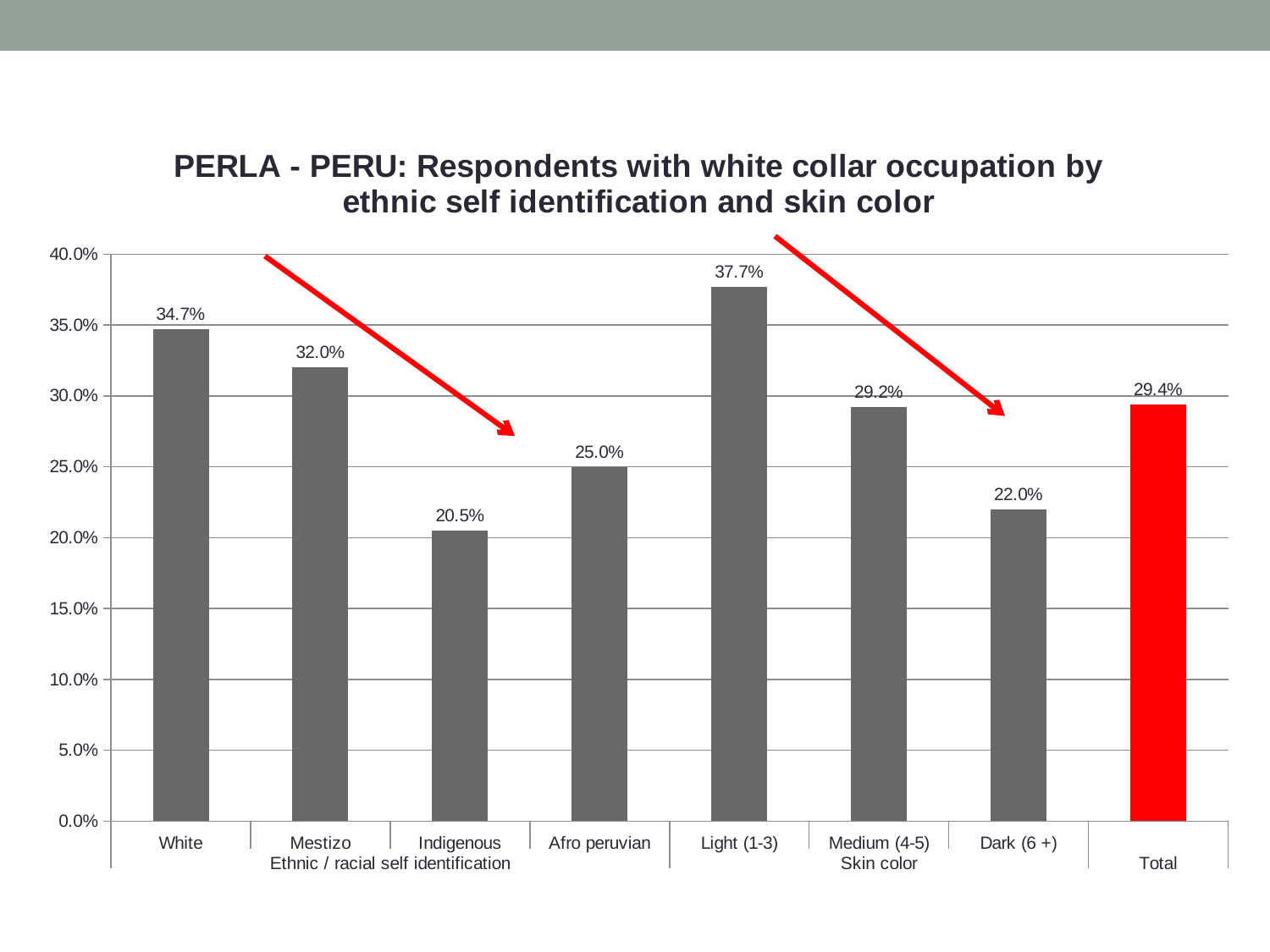
What is the difference between the values for Light (1-3) and Dark (6 +)? 15.7% What colour is the Total bar? Red Which is larger, the value for Afro peruvian or the value for Medium (4-5)? Medium (4-5) What is the value for Indigenous? 20.5% What is the value for White? 34.7% How many bars are shown in the chart? 8 What kind of chart is this? Bar chart Which category has the highest value? Light (1-3) What is the difference between the values for White and Mestizo? 2.7% Which category has the lowest value? Indigenous What is the value for Light (1-3)? 37.7% What is the value for Total? 29.4%